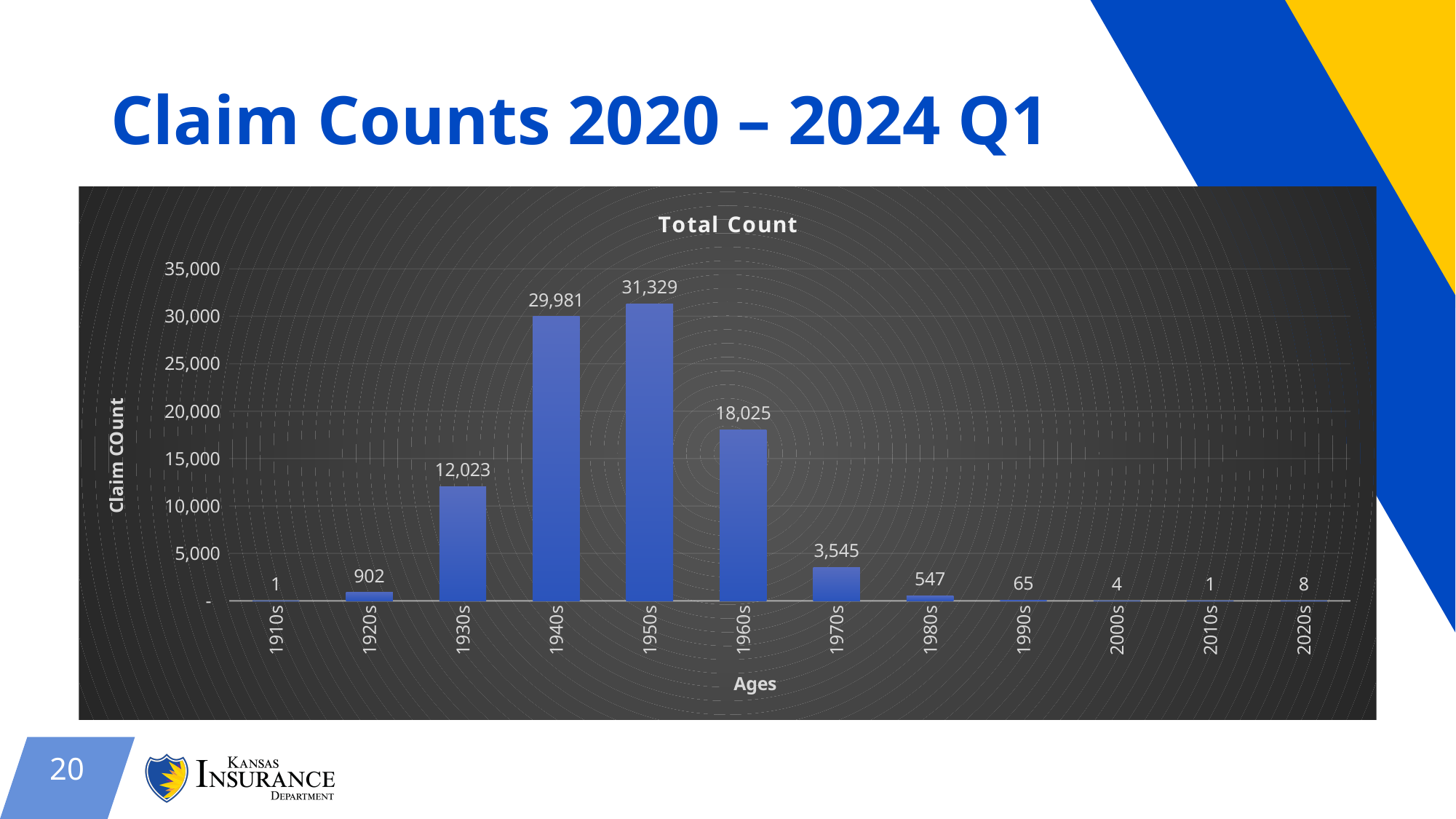
Which is larger, the value for the 1940s or the value for the 1950s? 1950s What is the difference between the values for the 1950s and the 1940s? 1,348 What is the value for the 1950s in the Total Count chart? 31,329 Do the values rise or fall from the 1950s to the 1990s? fall How many age categories are shown on the x axis? 12 Is the value for the 1960s greater or less than 15,000? greater Which age category has the highest total count? 1950s What is the value for the 1980s in the Total Count chart? 547 What kind of chart is shown on the slide? bar chart What is the difference between the values for the 1960s and the 1970s? 14,480 What is the value for the 1930s in the Total Count chart? 12,023 What is the title of the x axis? Ages